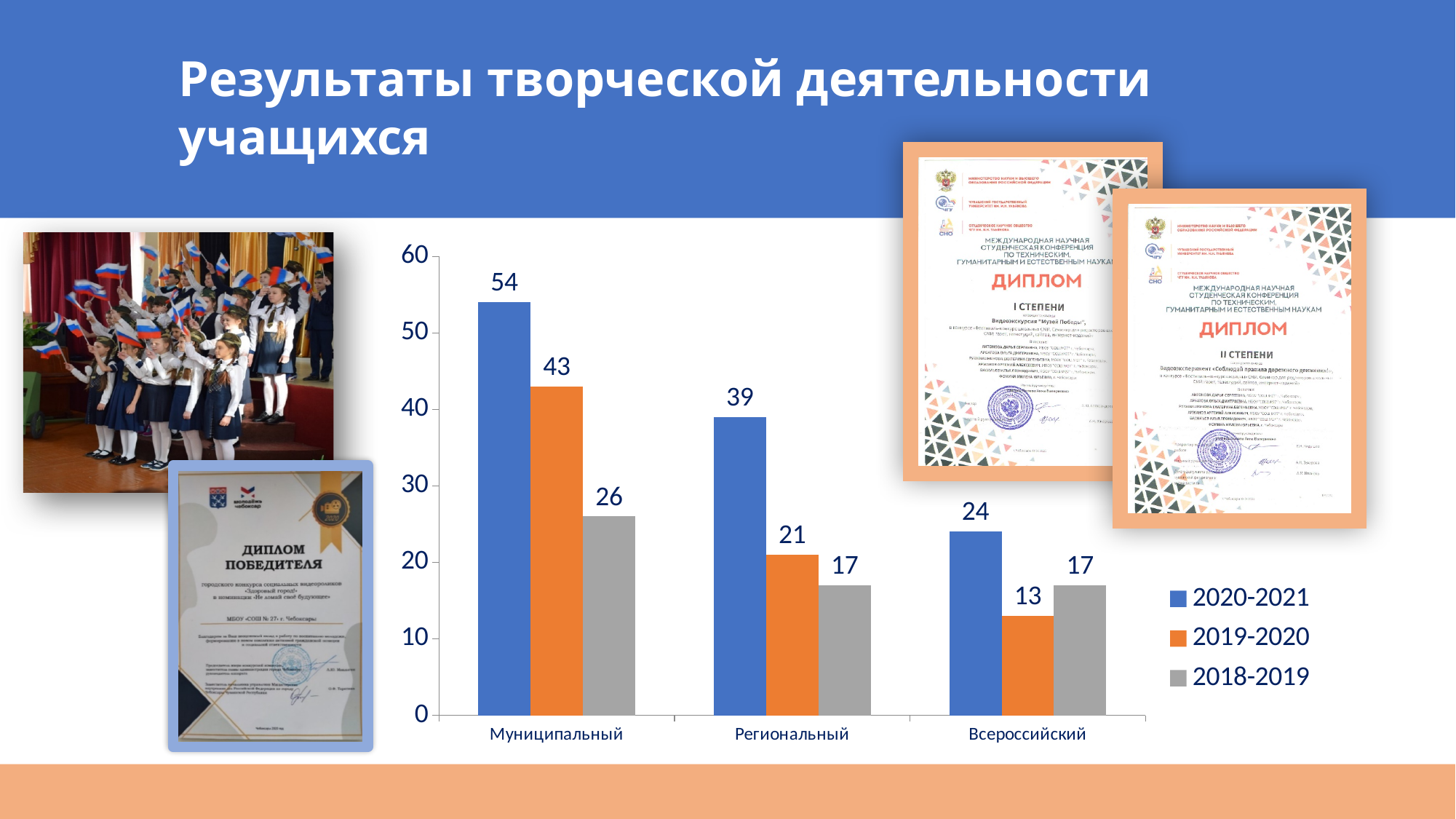
Is the value for 2020-2021 in the Региональный category greater or less than 30? greater What is the value for 2020-2021 in the Муниципальный category? 54 What kind of chart is shown on the slide? bar chart Which category has the lowest value for the 2019-2020 series? Всероссийский What is the difference between the 2020-2021 and 2019-2020 values in the Муниципальный category? 11 How many series does the legend list? 3 How many categories are shown on the x axis of the chart? 3 What is the value for 2019-2020 in the Региональный category? 21 Which category has the highest value for the 2020-2021 series? Муниципальный In the Всероссийский category, which is larger: the 2019-2020 value or the 2018-2019 value? 2018-2019 Which colour represents the 2019-2020 series in the legend? orange What is the value for 2018-2019 in the Всероссийский category? 17